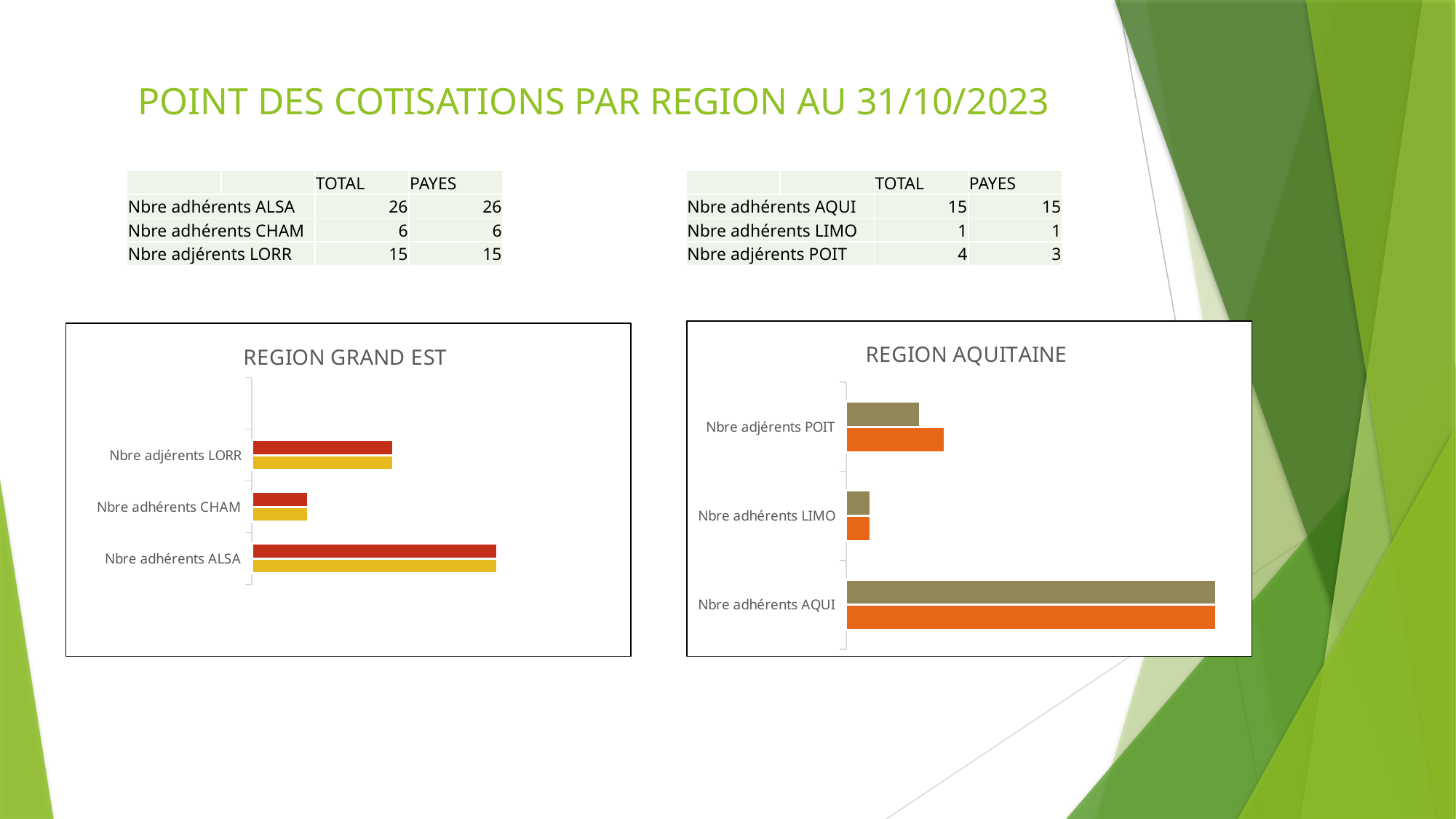
What kind of chart is the REGION GRAND EST chart? bar chart On the REGION GRAND EST chart, which category has the shortest bars? Nbre adhérents CHAM What is the title of the chart on the right side of the slide? REGION AQUITAINE What colours are the two bars for each category on the REGION GRAND EST chart? red and yellow On the REGION GRAND EST chart, which has the larger bars: Nbre adjérents LORR or Nbre adhérents CHAM? Nbre adjérents LORR How many categories are shown on the REGION AQUITAINE chart? 3 On the REGION AQUITAINE chart, which category has the shortest bars? Nbre adhérents LIMO On the REGION AQUITAINE chart, which category has the longest bars? Nbre adhérents AQUI How many categories are shown on the REGION GRAND EST chart? 3 On the REGION GRAND EST chart, which category has the longest bars? Nbre adhérents ALSA On the REGION AQUITAINE chart, which has the larger bars: Nbre adjérents POIT or Nbre adhérents LIMO? Nbre adjérents POIT What kind of chart is the REGION AQUITAINE chart? bar chart